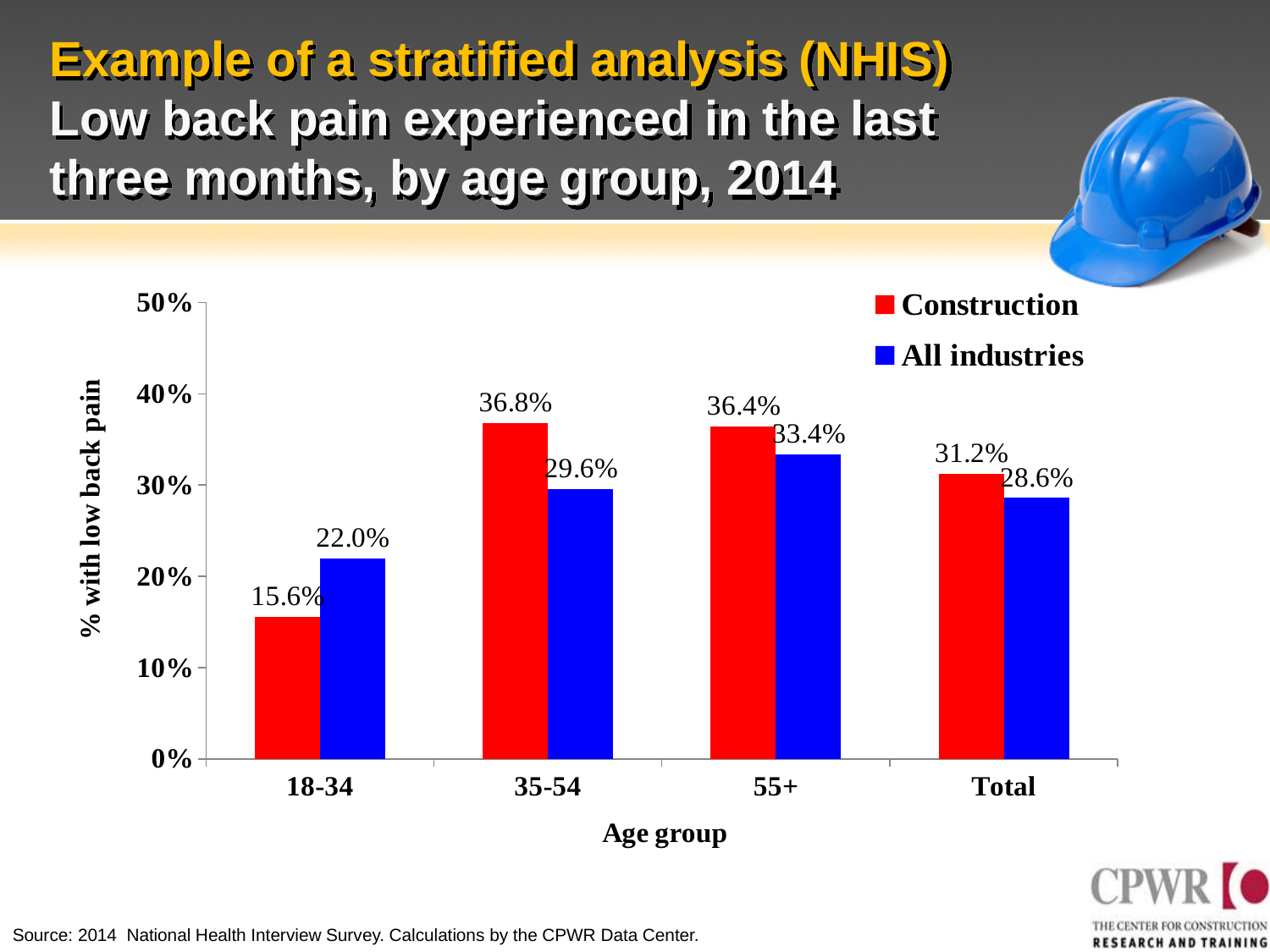
How many series does the legend list? 2 In the 18-34 age group, which is larger: Construction or All industries? All industries What is the difference between Construction and All industries in the 55+ age group? 3.0% What colour represents the Construction series? red Is the value for All industries in the Total category greater or less than 30%? less What is the value for Construction in the Total category? 31.2% What kind of chart is shown on the slide? bar chart Which age group has the lowest value for All industries? 18-34 How many categories are shown on the x axis? 4 What is the value for All industries in the 35-54 age group? 29.6% Which age group has the highest value for Construction? 35-54 What is the value for Construction in the 18-34 age group? 15.6%